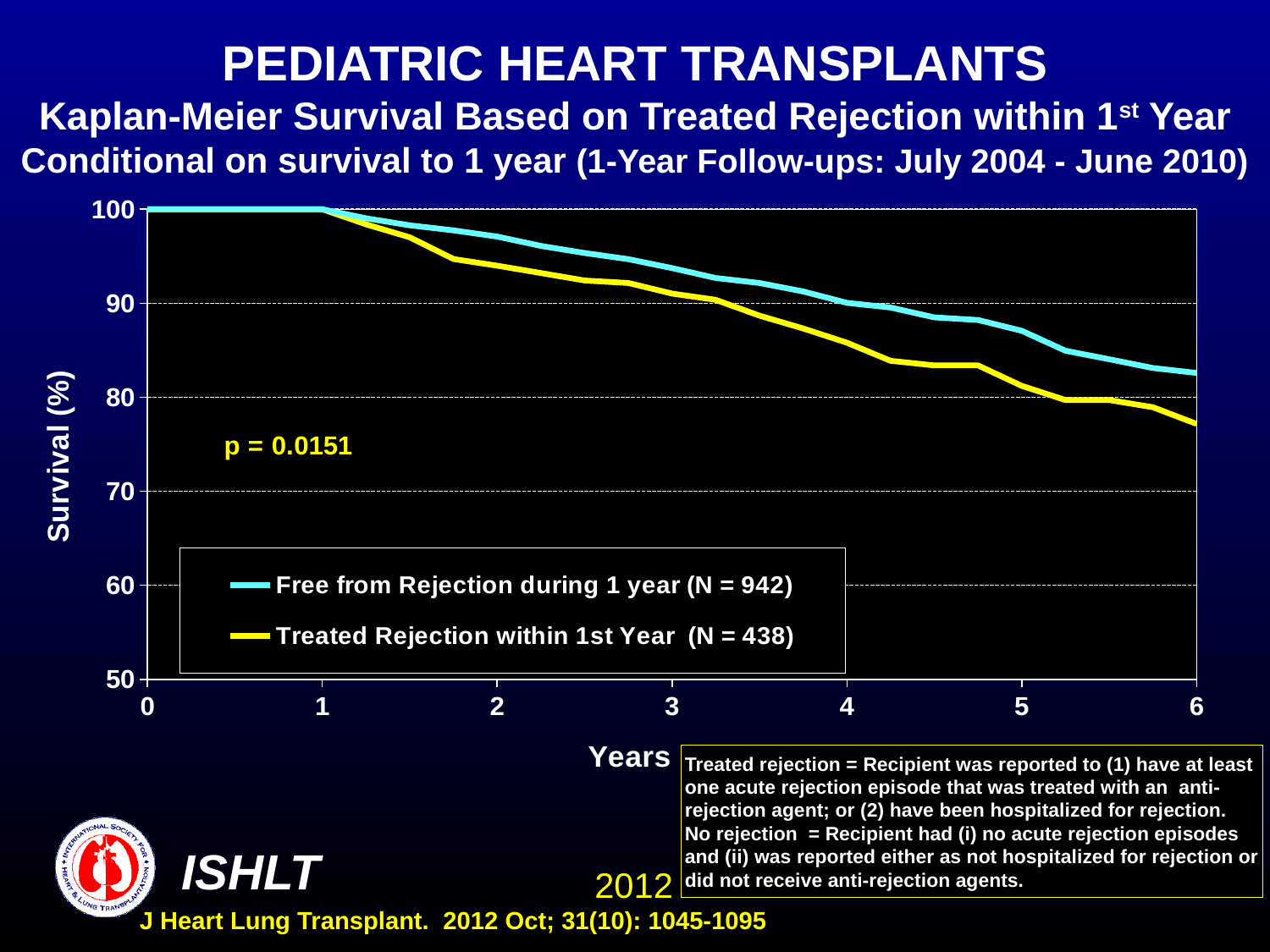
Is the survival for the 'Free from Rejection during 1 year' group at 5 years greater or less than 90? less Do the survival curves rise or fall as years increase? fall How many series does the legend list? 2 Is the survival for the 'Free from Rejection during 1 year' group at 6 years greater or less than 80? greater What is the N for the 'Free from Rejection during 1 year' group? 942 What is the label of the y axis? Survival (%) Is the survival for the 'Treated Rejection within 1st Year' group at 6 years greater or less than 80? less Which group has higher survival at 6 years, 'Free from Rejection during 1 year' or 'Treated Rejection within 1st Year'? Free from Rejection during 1 year What kind of chart is shown on the slide? line chart What is the N for the 'Treated Rejection within 1st Year' group? 438